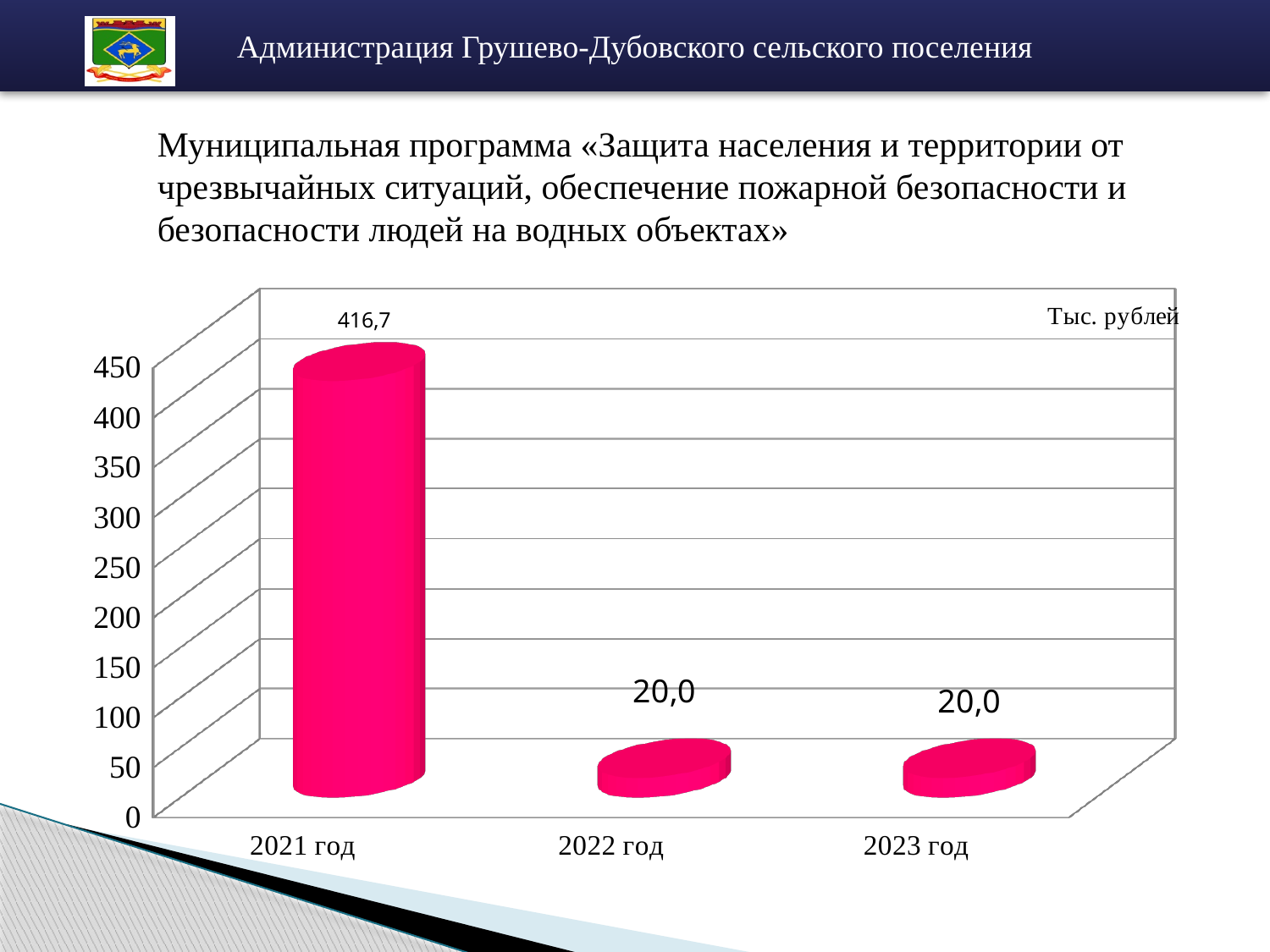
What is the value for 2022 год? 20,0 How many years are shown on the x axis? 3 What is the value for 2023 год? 20,0 What unit is indicated in the top right corner of the chart? Тыс. рублей Which year has the highest value? 2021 год Is the value for 2021 год greater or less than 400? greater Which is larger, the value for 2021 год or the value for 2023 год? 2021 год What is the difference between the values for 2021 год and 2022 год? 396,7 What kind of chart is shown on the slide? bar chart Do the values rise or fall from 2021 год to 2022 год? fall What is the value for 2021 год? 416,7 Is the value for 2022 год greater or less than 50? less